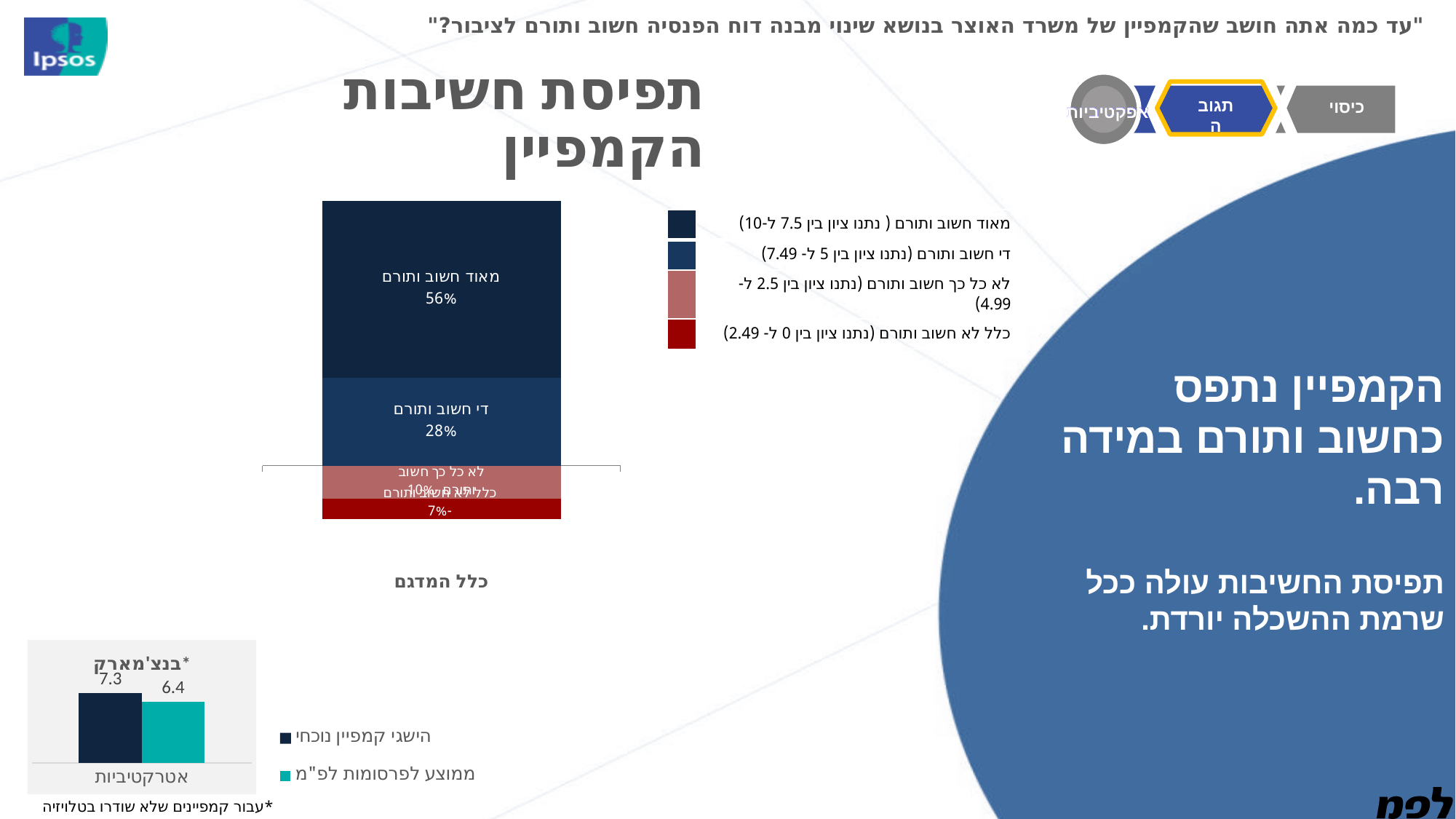
In the stacked bar chart titled "תפיסת חשיבות הקמפיין", which segment has the largest share? מאוד חשוב ותורם In the stacked bar chart titled "תפיסת חשיבות הקמפיין", what is the label of the single bar on the x axis? כלל המדגם In the stacked bar chart titled "תפיסת חשיבות הקמפיין", which segment has the smallest share? כלל לא חשוב ותורם In the stacked bar chart titled "תפיסת חשיבות הקמפיין", what percentage is shown for "כלל לא חשוב ותורם"? 7% In the stacked bar chart titled "תפיסת חשיבות הקמפיין", what percentage is shown for "די חשוב ותורם"? 28% In the benchmark chart at the bottom left ("בנצ'מארק"), which is larger: "הישגי קמפיין נוכחי" or "ממוצע לפרסומות לפ"מ"? הישגי קמפיין נוכחי In the stacked bar chart titled "תפיסת חשיבות הקמפיין", how many entries does the legend list? 4 In the stacked bar chart titled "תפיסת חשיבות הקמפיין", what is the difference in percentage points between "מאוד חשוב ותורם" and "די חשוב ותורם"? 28 In the benchmark chart at the bottom left ("בנצ'מארק"), what value is shown for "ממוצע לפרסומות לפ"מ"? 6.4 In the benchmark chart at the bottom left ("בנצ'מארק"), what is the difference between the two values shown? 0.9 In the stacked bar chart titled "תפיסת חשיבות הקמפיין", what percentage is shown for "מאוד חשוב ותורם"? 56% In the benchmark chart at the bottom left ("בנצ'מארק"), what value is shown for "הישגי קמפיין נוכחי"? 7.3